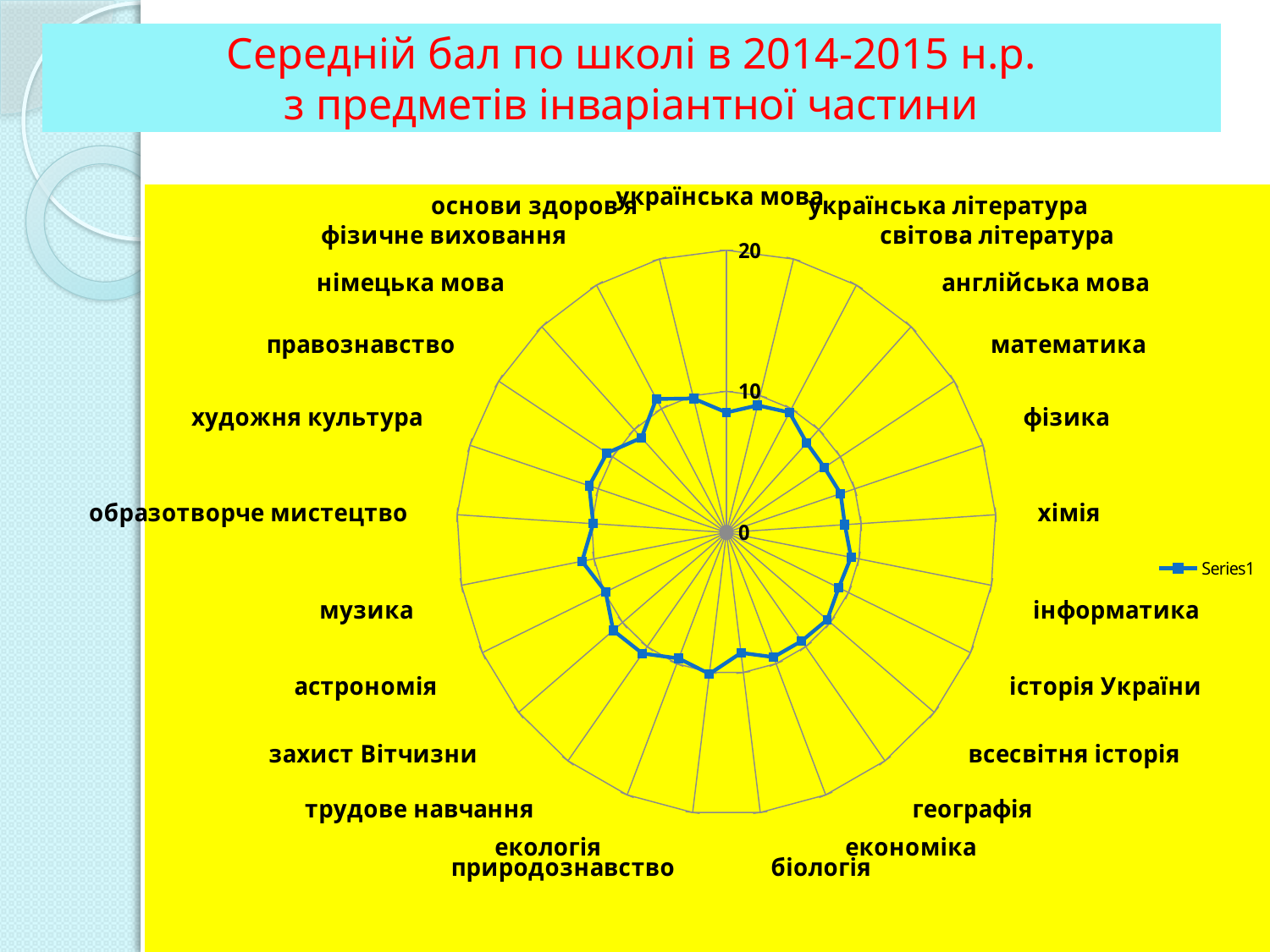
How many series does the legend list? 1 Is the value for хімія greater or less than 20? less How many subjects (categories) are plotted on the radar chart? 25 Is the value for математика greater or less than 20? less What is the name of the series shown in the legend? Series1 Is the value for українська мова greater or less than 10? less What is the highest value shown on the chart's axis scale? 20 What kind of chart is shown on the slide? radar chart